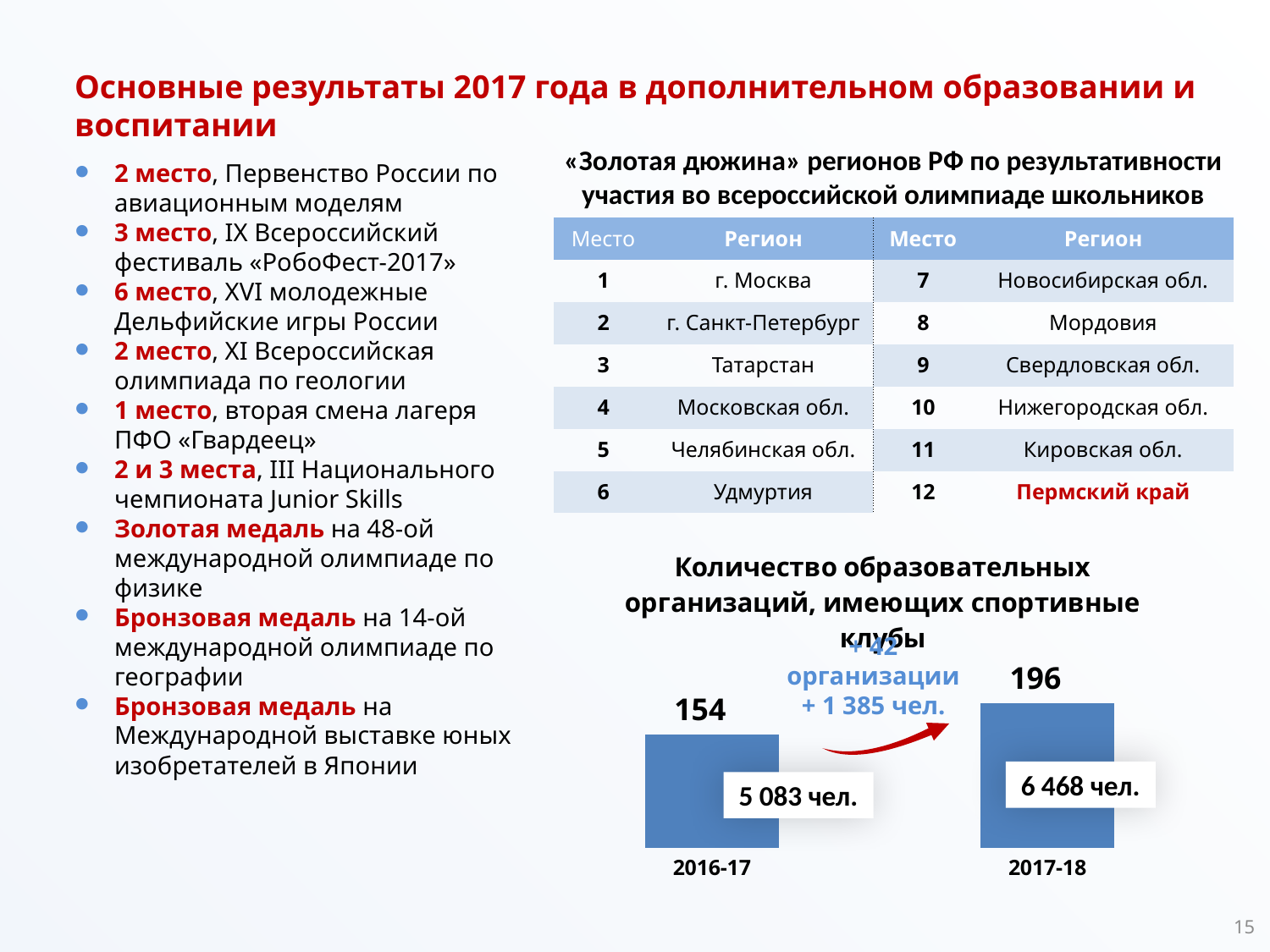
What kind of chart is "Количество образовательных организаций, имеющих спортивные клубы"? bar chart In the chart "Количество образовательных организаций, имеющих спортивные клубы", what is the value for 2016-17? 154 In the chart "Количество образовательных организаций, имеющих спортивные клубы", how many people (чел.) are shown for 2017-18? 6 468 чел. How many bars are shown in the chart "Количество образовательных организаций, имеющих спортивные клубы"? 2 In the chart "Количество образовательных организаций, имеющих спортивные клубы", do the values rise or fall from 2016-17 to 2017-18? rise In the chart "Количество образовательных организаций, имеющих спортивные клубы", which period has the higher number of organisations? 2017-18 In the chart "Количество образовательных организаций, имеющих спортивные клубы", what is the difference between the 2017-18 and 2016-17 values? 42 In the chart "Количество образовательных организаций, имеющих спортивные клубы", by how many people (чел.) did the number grow from 2016-17 to 2017-18? 1 385 чел. In the chart "Количество образовательных организаций, имеющих спортивные клубы", which period has the lower number of organisations? 2016-17 In the chart "Количество образовательных организаций, имеющих спортивные клубы", what is the value for 2017-18? 196 In the chart "Количество образовательных организаций, имеющих спортивные клубы", is the value for 2017-18 larger or smaller than the value for 2016-17? larger In the chart "Количество образовательных организаций, имеющих спортивные клубы", how many people (чел.) are shown for 2016-17? 5 083 чел.